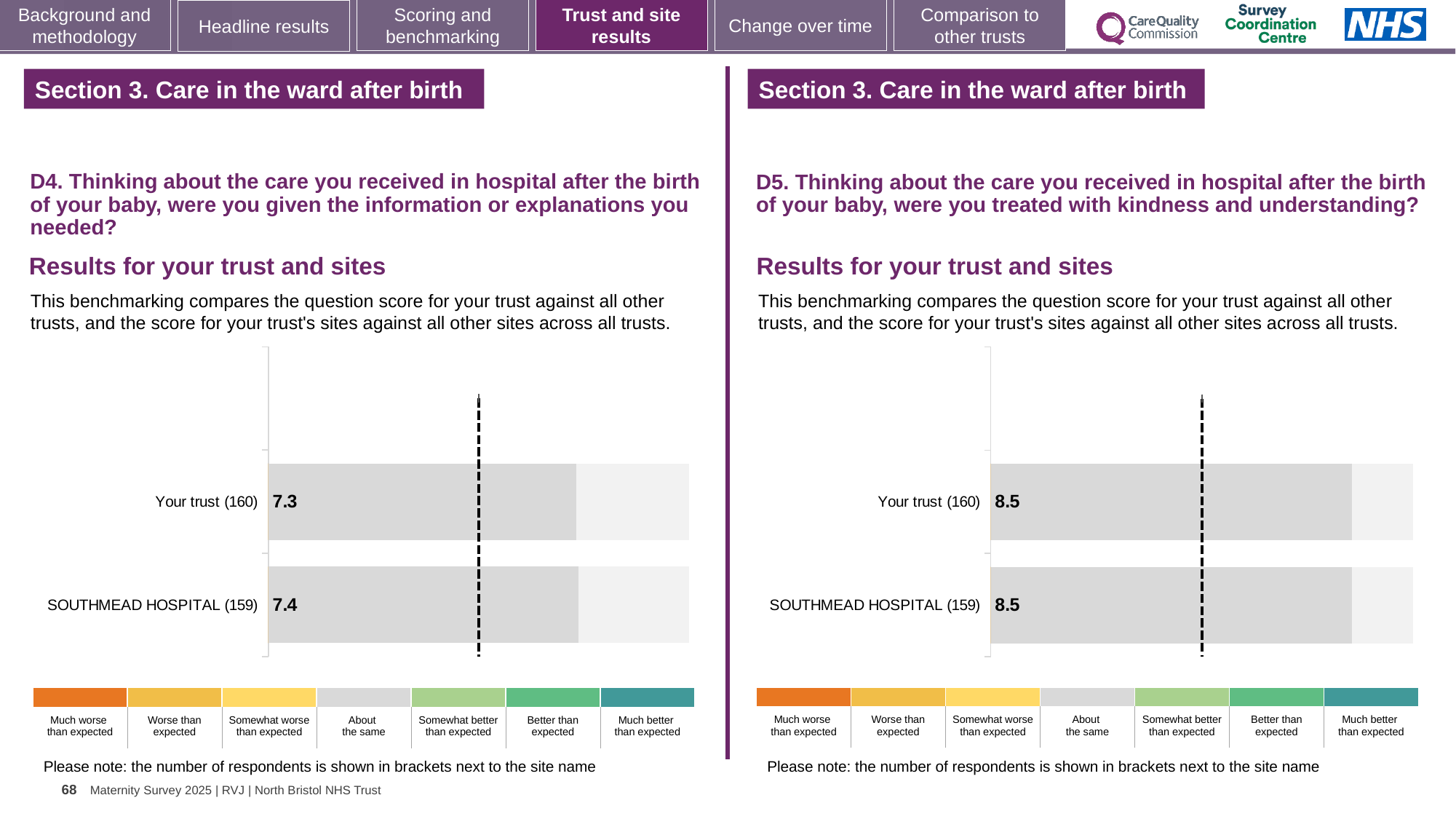
On the right chart (D5), what is the difference between the Your trust score and the SOUTHMEAD HOSPITAL score? 0 What kind of chart is used on the left (D4)? Bar chart On the left chart (D4), how many respondents are shown in brackets for SOUTHMEAD HOSPITAL? 159 On the left chart (D4), what is the score for SOUTHMEAD HOSPITAL (159)? 7.4 On the right chart (D5), what is the score for SOUTHMEAD HOSPITAL (159)? 8.5 On the left chart (D4), what is the difference between the SOUTHMEAD HOSPITAL score and the Your trust score? 0.1 On the right chart (D5), how many respondents are shown in brackets for Your trust? 160 On the right chart (D5), what is the score for Your trust (160)? 8.5 How many bars are plotted on the left chart (D4)? 2 How many bars are plotted on the right chart (D5)? 2 On the left chart (D4), what is the score for Your trust (160)? 7.3 What kind of chart is used on the right (D5)? Bar chart